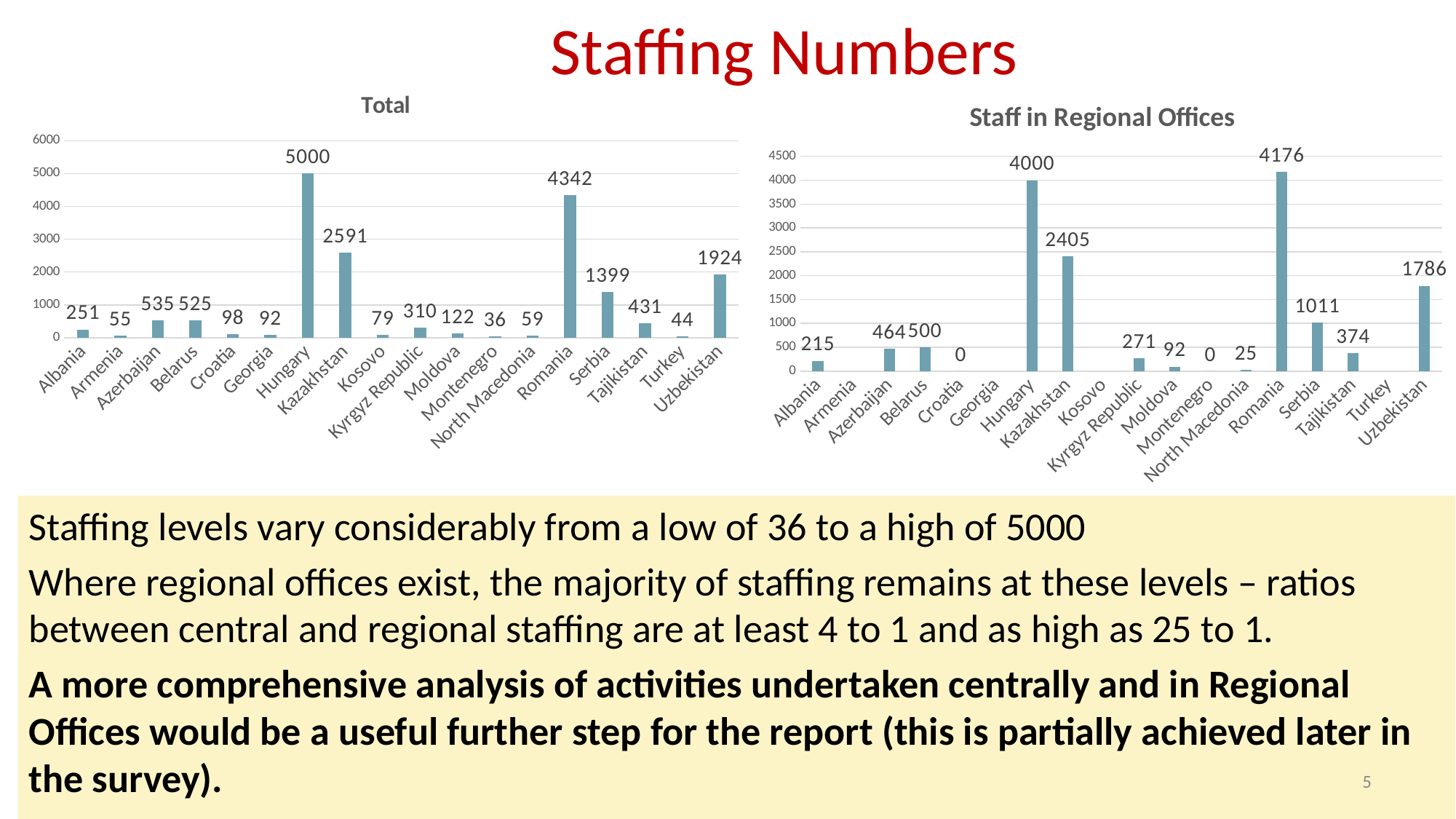
In the Staff in Regional Offices chart, which is larger, the value for Kazakhstan or the value for Uzbekistan? Kazakhstan In the Total chart, what is the value for Hungary? 5000 In the Staff in Regional Offices chart, what is the value for Kyrgyz Republic? 271 In the Total chart, what is the difference between the values for Hungary and Romania? 658 In the Total chart, what is the value for Montenegro? 36 In the Staff in Regional Offices chart, what is the value for Romania? 4176 In the Total chart, which country has the highest value? Hungary In the Total chart, which country has the lowest value? Montenegro What is the title of the chart on the right side of the slide? Staff in Regional Offices How many countries are shown on the x axis of the Total chart? 18 What kind of chart is the Staff in Regional Offices chart? Bar chart In the Staff in Regional Offices chart, which country has the highest value? Romania